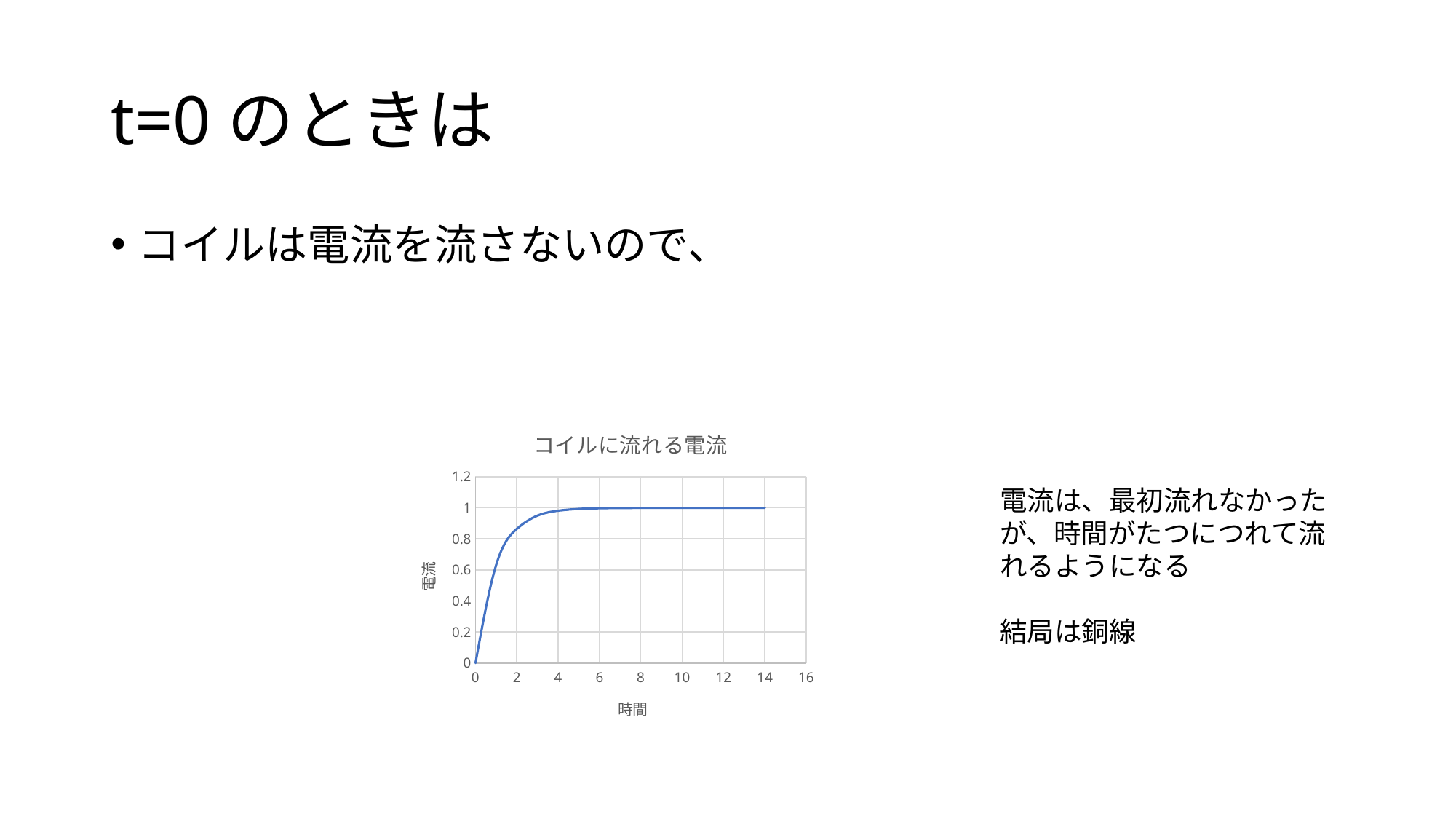
At what value does the current level off for large times? 1 Is the value of the current at time 4 greater or less than 0.6? greater What kind of chart is shown on the slide? line chart What is the title of the chart? コイルに流れる電流 Is the value of the current at time 8 greater or less than 0.8? greater Does the current (電流) rise or fall as time (時間) increases along the x axis? rise Is the value of the current at time 12 greater or less than 1.2? less What is the label of the x axis of the chart? 時間 What is the value of the current at time 0? 0 Is the current at time 14 larger or smaller than the current at time 0? larger What is the highest tick value shown on the y axis? 1.2